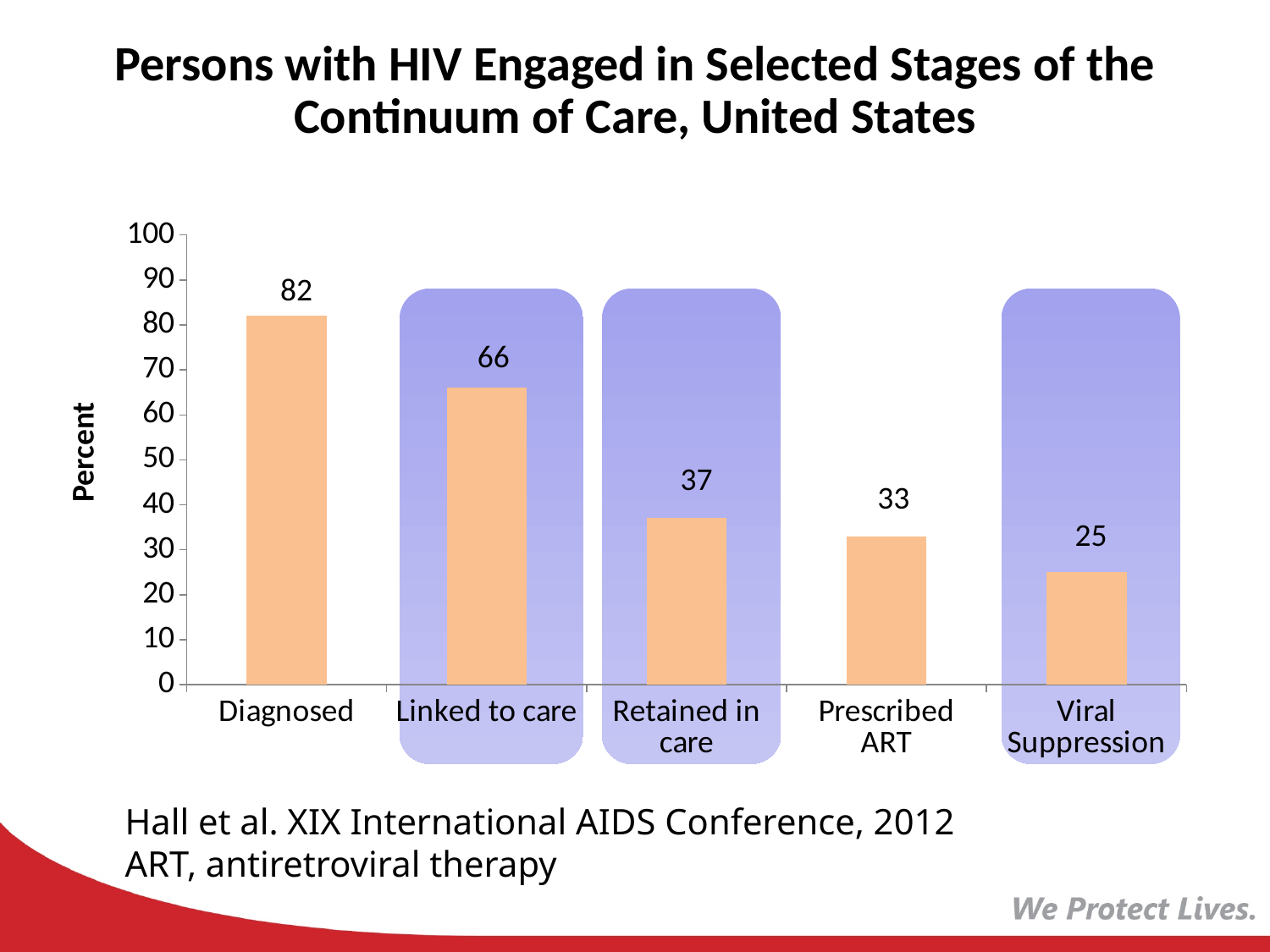
What is the value for Diagnosed? 82 Which stage has the highest value? Diagnosed Do the values rise or fall from left to right across the stages? Fall What is the value for Linked to care? 66 Which is larger, the value for Retained in care or the value for Prescribed ART? Retained in care What is the value for Retained in care? 37 Which stage has the lowest value? Viral Suppression How many stages are shown on the chart? 5 What is the value for Prescribed ART? 33 What kind of chart is this? Bar chart What is the value for Viral Suppression? 25 What is the difference between the values for Diagnosed and Linked to care? 16